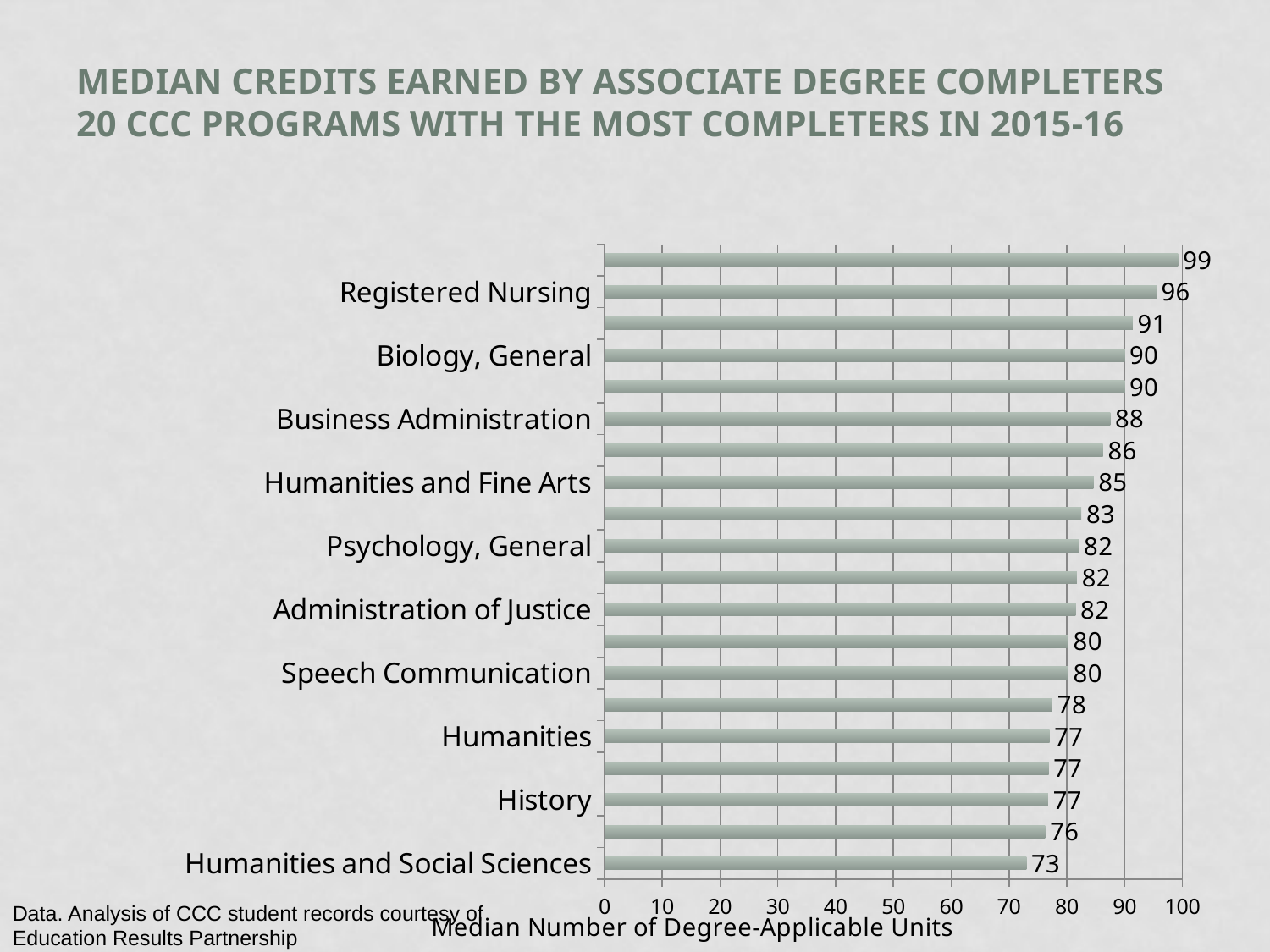
What is the difference between the values for Registered Nursing and Humanities and Social Sciences? 23 What kind of chart is shown on the slide? Bar chart What is the value shown for Humanities and Social Sciences? 73 Which labeled program has the lowest median number of degree-applicable units? Humanities and Social Sciences What is the median number of degree-applicable units for Registered Nursing? 96 What is the title of the horizontal axis? Median Number of Degree-Applicable Units How many bars are plotted on the chart? 20 Is the value for Registered Nursing greater or less than 90? greater What is the value shown for Business Administration? 88 What is the highest value shown on the chart? 99 Which has a higher value, Biology, General or Business Administration? Biology, General What is the value shown for Speech Communication? 80